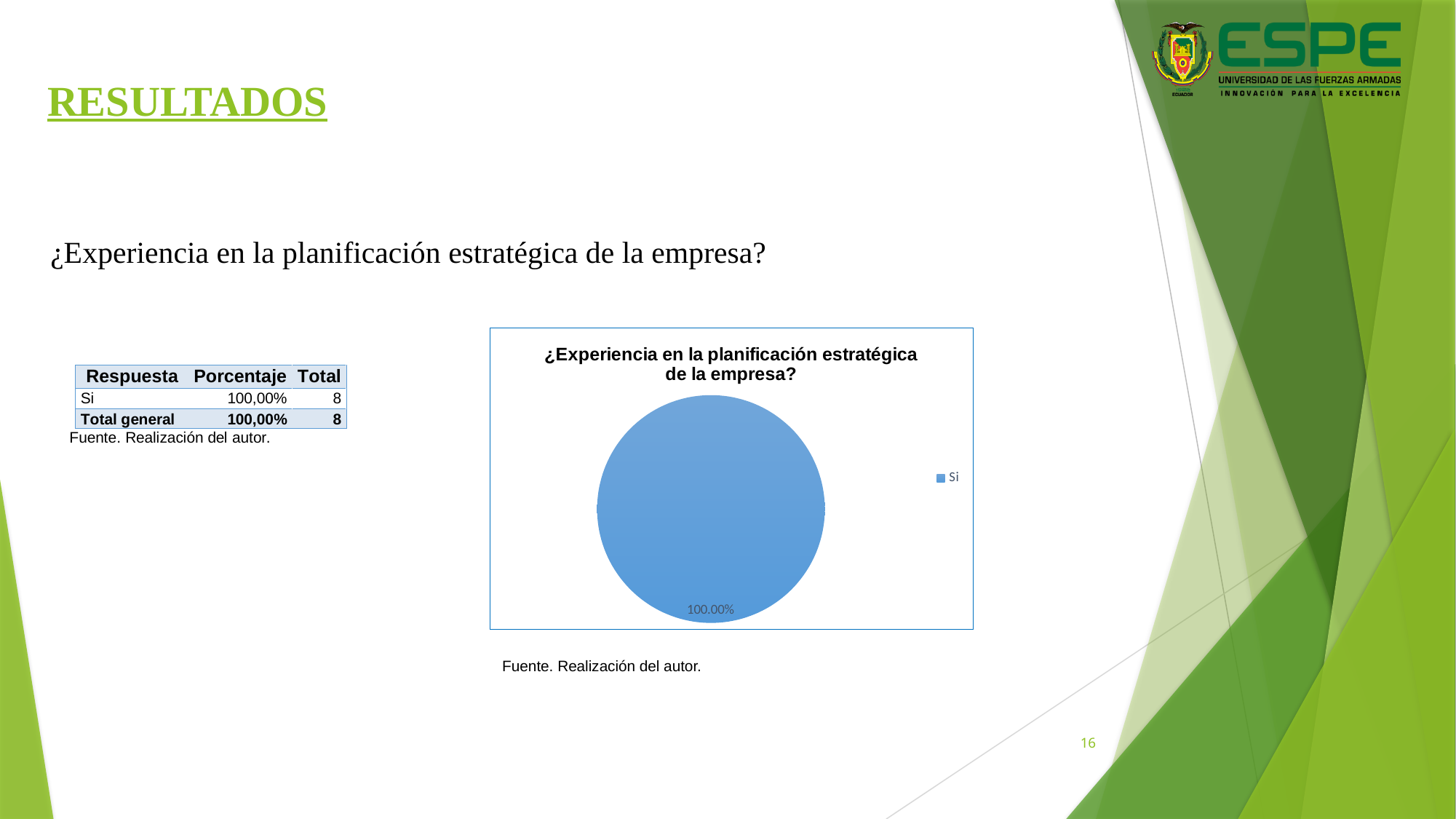
What is the title of the pie chart? ¿Experiencia en la planificación estratégica de la empresa? How many entries does the legend of the pie chart list? 1 What kind of chart is shown on the slide? Pie chart How many slices does the pie chart have? 1 Is the share of the 'Si' slice greater or less than 50%? greater What percentage is shown on the data label of the pie chart? 100.00% What is the legend entry of the pie chart? Si What share of the pie does the 'Si' slice represent? 100.00%